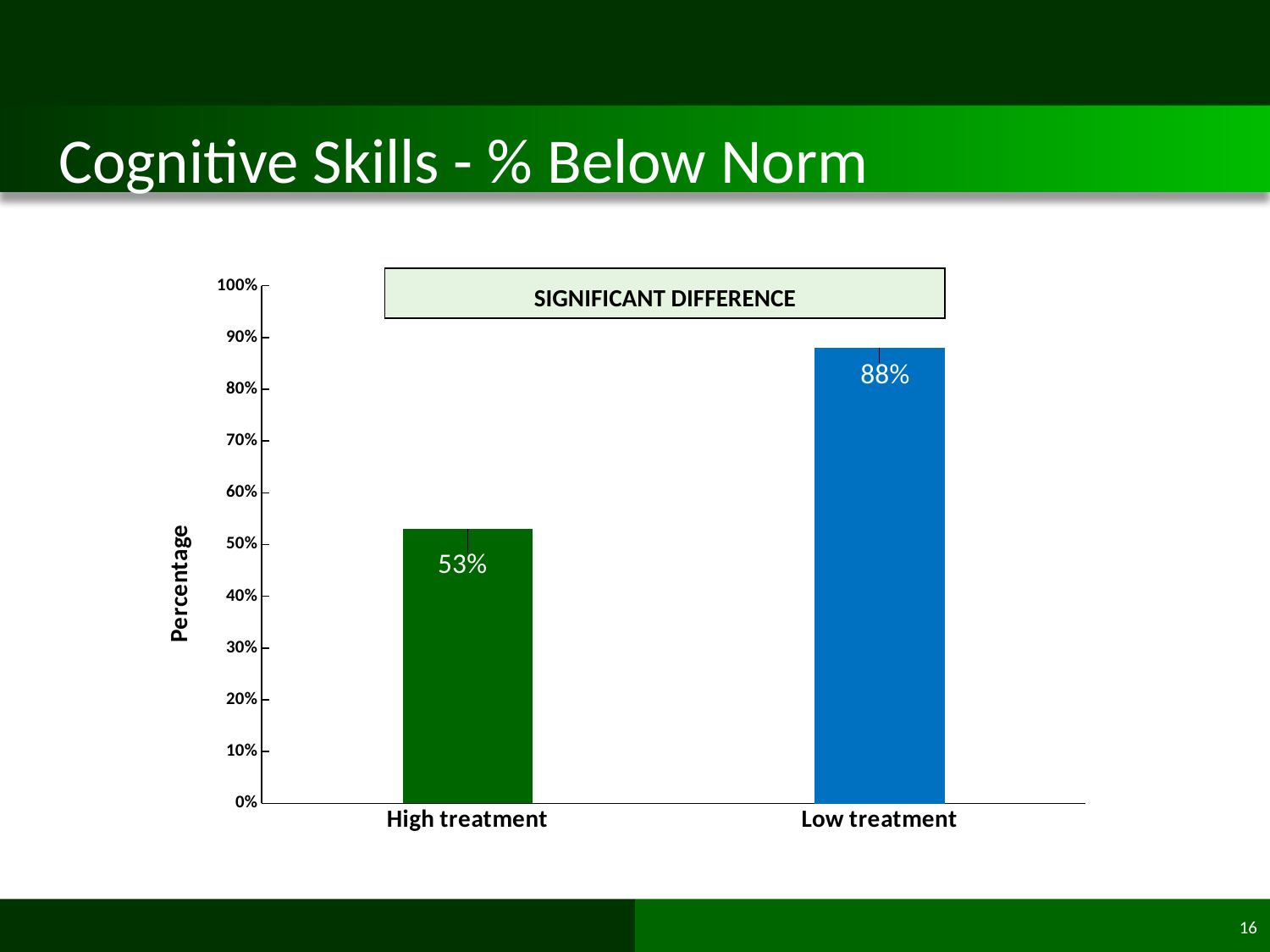
What is the value for Low treatment? 88% What is the label of the y axis? Percentage Which category has the highest percentage? Low treatment What is the difference between the Low treatment and High treatment values? 35% Is the value for High treatment greater or less than 60%? less Which category has the lowest percentage? High treatment What kind of chart is shown on the slide? Bar chart How many categories are shown on the x axis? 2 Is the value for Low treatment greater or less than 80%? greater Which is larger, the value for High treatment or the value for Low treatment? Low treatment What text appears in the box above the bars? SIGNIFICANT DIFFERENCE What is the value for High treatment? 53%